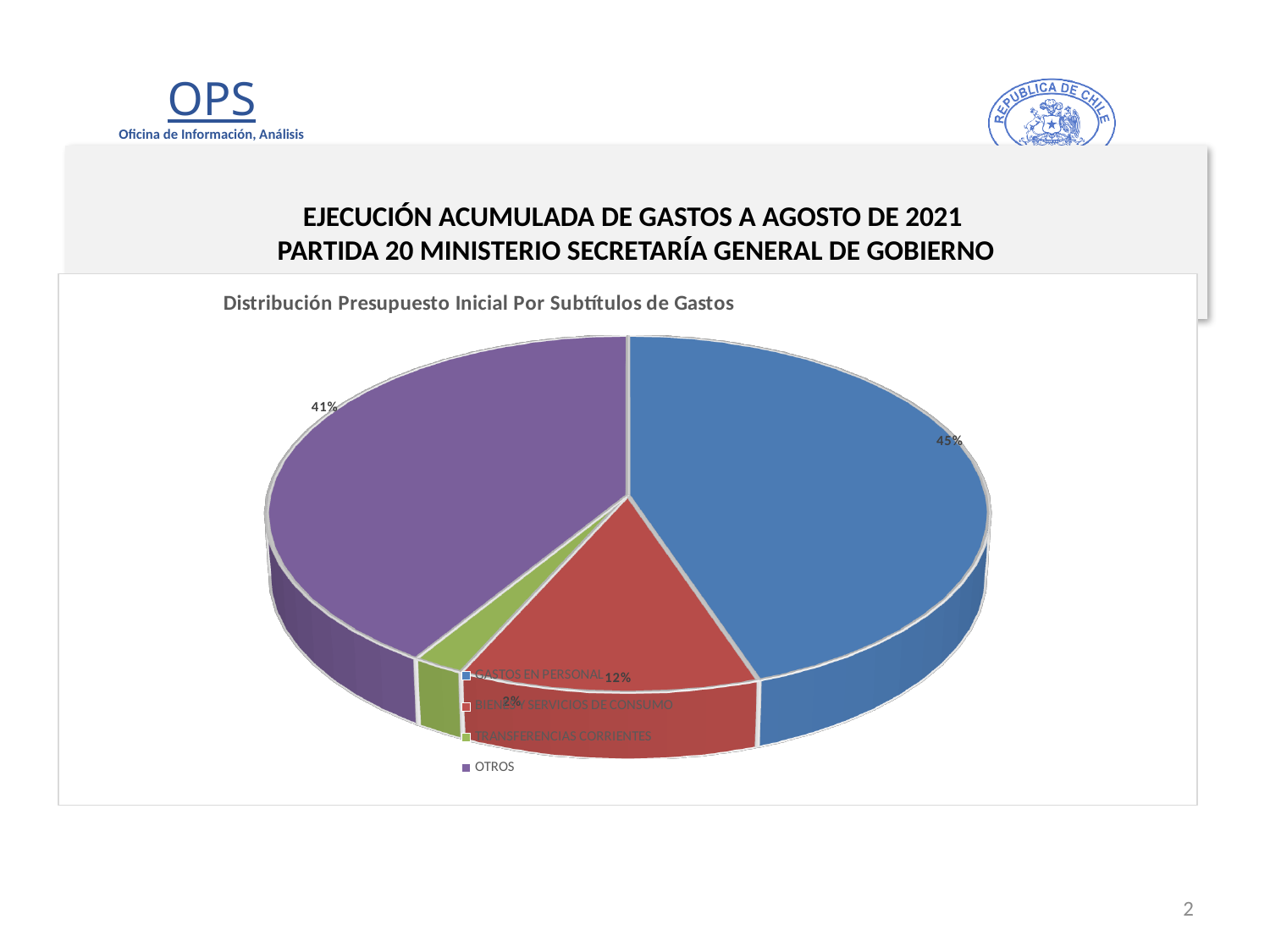
How many categories does the pie chart have? 4 What share of the pie does OTROS represent? 41% What colour is the slice for OTROS? purple What is the chart's title? Distribución Presupuesto Inicial Por Subtítulos de Gastos Which category has the smallest share of the pie? TRANSFERENCIAS CORRIENTES Which category has the largest share of the pie? GASTOS EN PERSONAL Which is larger, the share for BIENES Y SERVICIOS DE CONSUMO or the share for TRANSFERENCIAS CORRIENTES? BIENES Y SERVICIOS DE CONSUMO What share of the pie does BIENES Y SERVICIOS DE CONSUMO represent? 12% What share of the pie does TRANSFERENCIAS CORRIENTES represent? 2% What is the difference in percentage points between GASTOS EN PERSONAL and OTROS? 4% What kind of chart is shown on the slide? pie chart